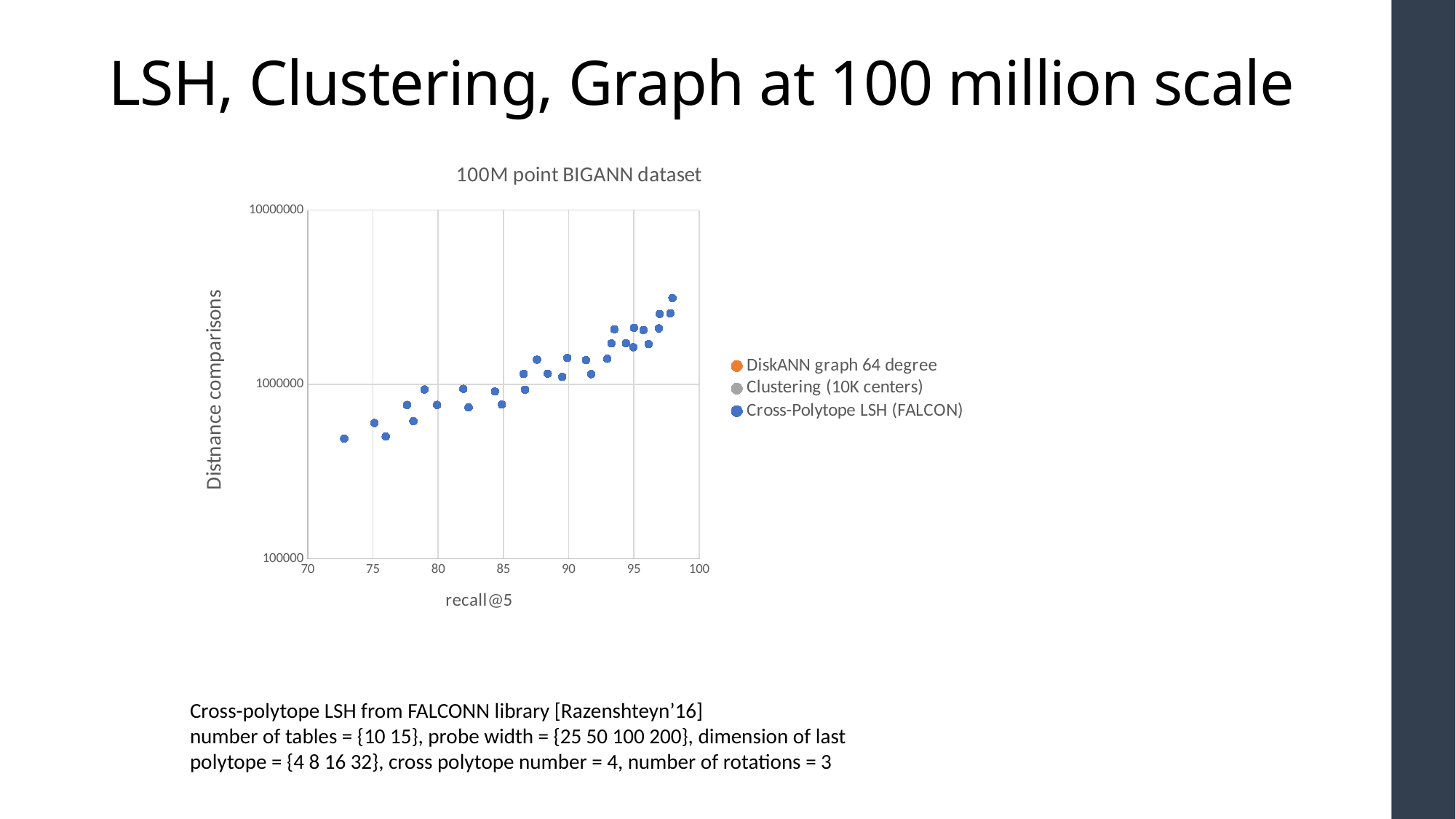
Is the lowest plotted point for Cross-Polytope LSH (FALCON) greater or less than 100000 distance comparisons? greater Which series in the legend is plotted with blue markers? Cross-Polytope LSH (FALCON) Is the highest plotted point for Cross-Polytope LSH (FALCON) greater or less than 1000000 distance comparisons? greater What is the title of the chart? 100M point BIGANN dataset Is the lowest plotted point for Cross-Polytope LSH (FALCON) greater or less than 1000000 distance comparisons? less What is the lowest value shown on the y axis of the chart? 100000 Which of the two is larger: the distance comparisons for the point at recall@5 of about 98, or the point at recall@5 of about 73? The point at about 98 How many series does the chart's legend list? 3 What is the label of the x axis of the chart? recall@5 What kind of chart is shown on the slide? Scatter chart Do the distance comparisons generally rise or fall as recall@5 increases along the x axis? Rise